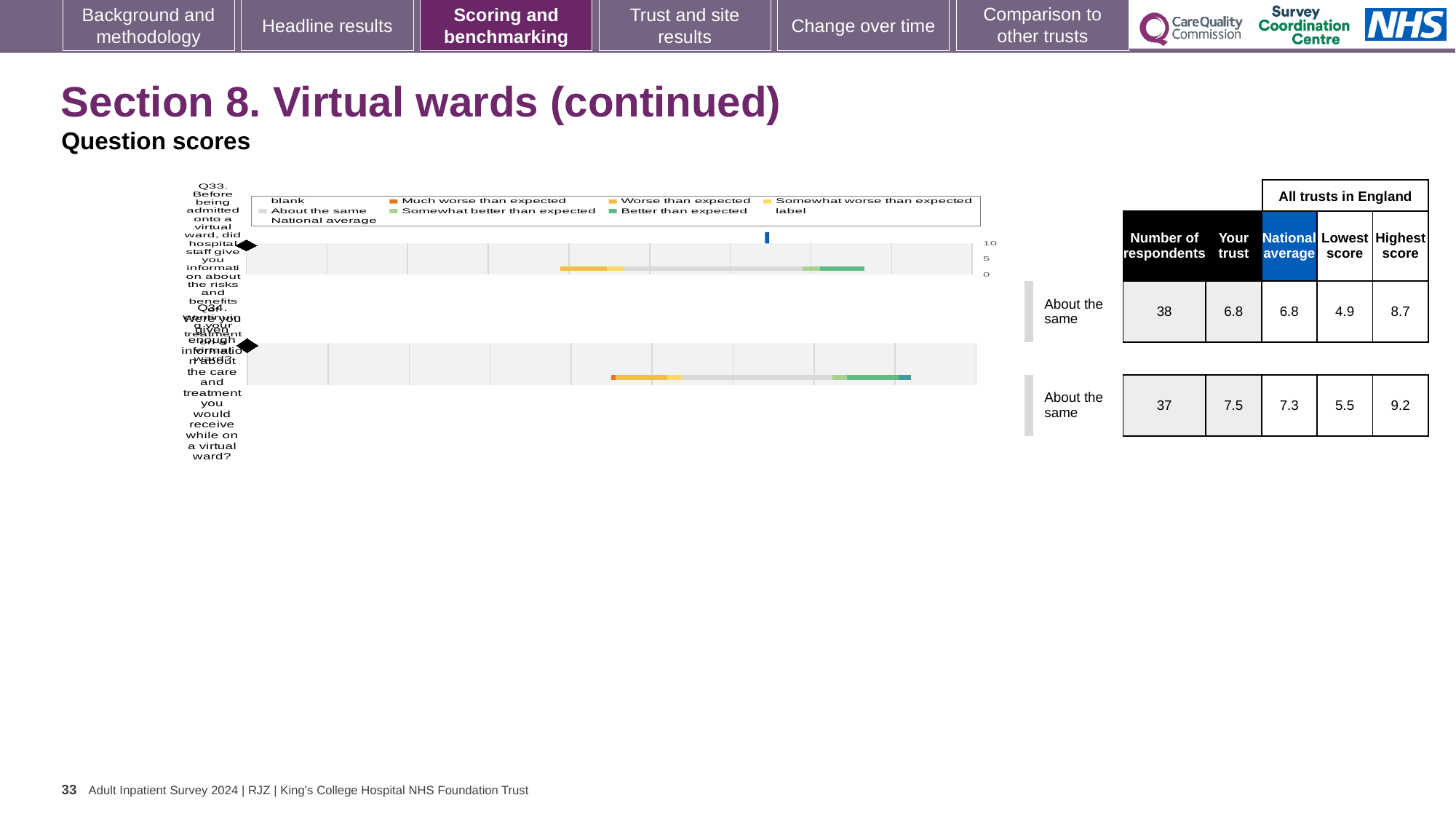
What benchmark category is shown beside the chart for Q33? About the same How many questions (categories) are plotted in the chart? 2 Which question has the higher 'Your trust' score, Q33 or Q34? Q34 In the table next to the chart, what is the highest score among all trusts in England for Q34? 9.2 In the table next to the chart, how many respondents answered Q33? 38 What is the difference between the highest score and the lowest score for Q34? 3.7 In the table next to the chart, what is the lowest score among all trusts in England for Q33? 4.9 In the table next to the chart, what is the national average for Q33? 6.8 For Q34, which is larger: the 'Your trust' score or the national average? Your trust What is the difference between the highest score and the lowest score for Q33? 3.8 What kind of chart is used to show the question scores for Q33 and Q34? bar chart In the table next to the chart, what is the 'Your trust' score for Q34? 7.5